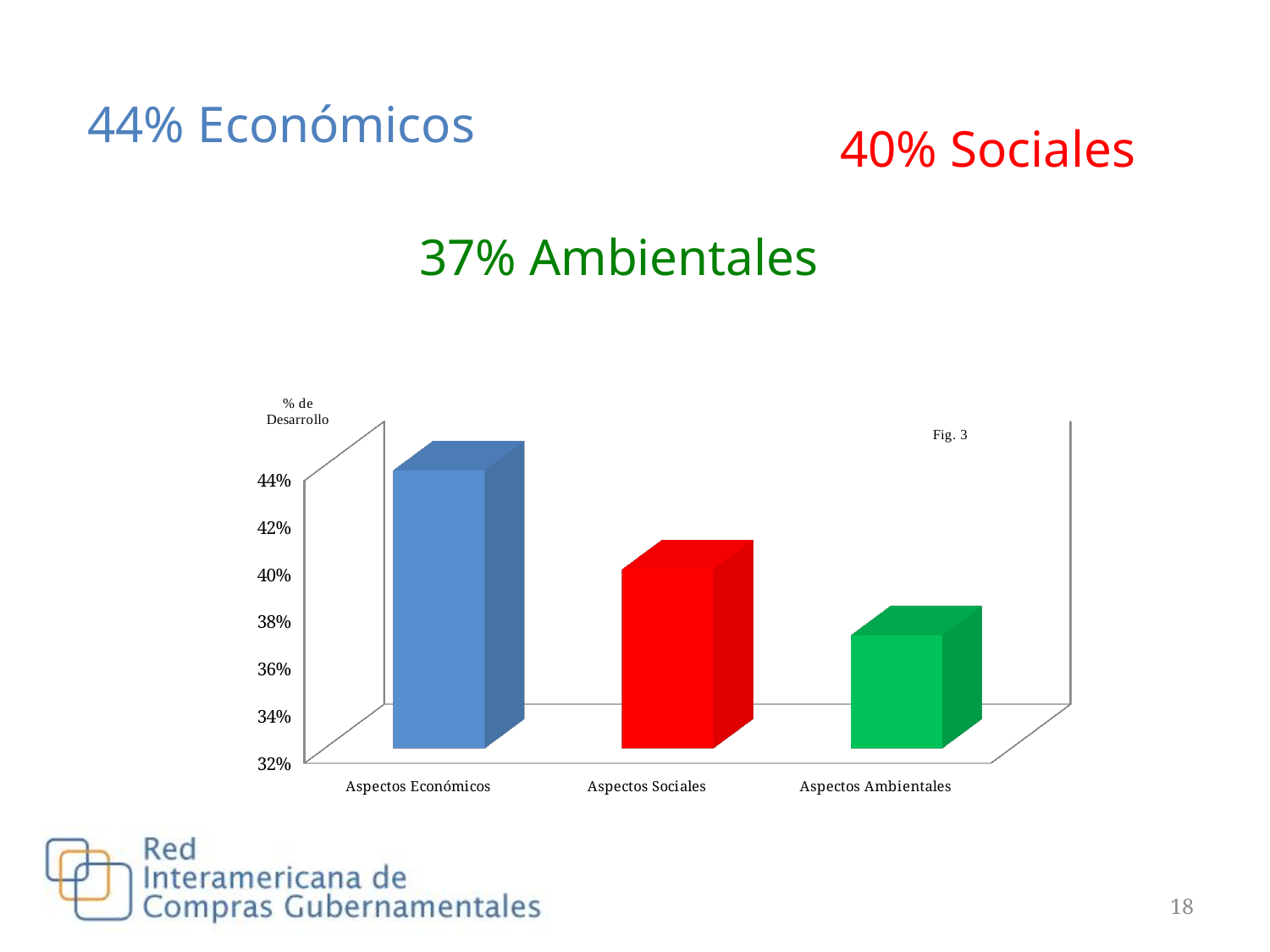
Is the value for Aspectos Sociales greater or less than 38%? greater Which category has the lowest value in the chart? Aspectos Ambientales How many categories are shown on the x axis of the chart? 3 What is the value for Aspectos Sociales? 40% What is the label on the vertical axis of the chart? % de Desarrollo Do the values rise or fall from left to right along the x axis? fall What is the value for Aspectos Ambientales? 37% Which category has the highest value in the chart? Aspectos Económicos Which is larger, the value for Aspectos Sociales or the value for Aspectos Ambientales? Aspectos Sociales What is the value for Aspectos Económicos? 44% What is the difference between the values for Aspectos Económicos and Aspectos Ambientales? 7% What kind of chart is shown on the slide? bar chart